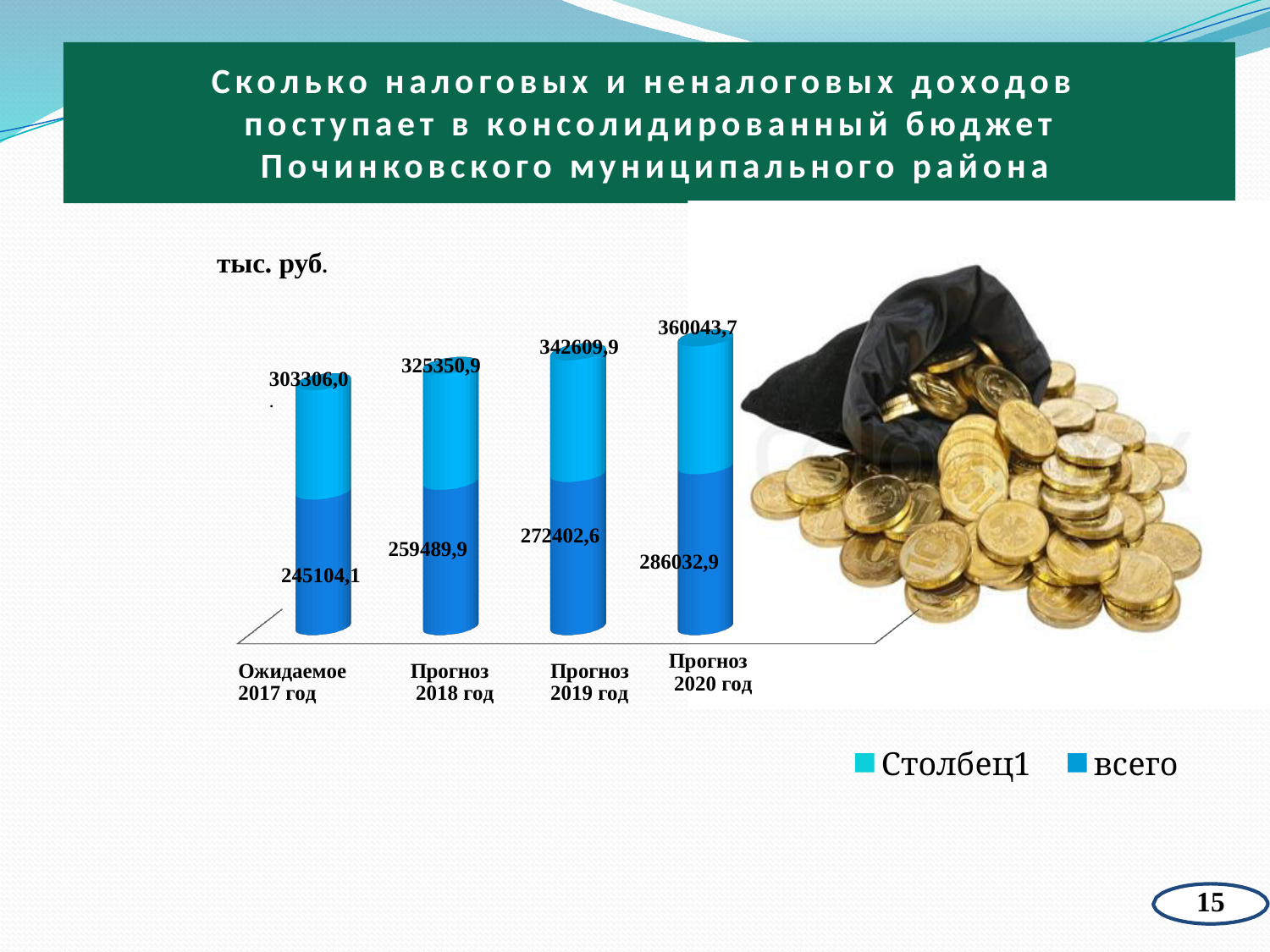
What is the value of the всего series for Прогноз 2019 год? 272402,6 What kind of chart is shown on the slide? bar chart Do the values of the всего series rise or fall from Ожидаемое 2017 год to Прогноз 2020 год? rise How many categories are shown along the x axis of the chart? 4 What unit label is printed above the chart? тыс. руб. What value is printed at the top of the bar for Прогноз 2018 год? 325350,9 Which category has the lowest value for the всего series? Ожидаемое 2017 год How many series does the chart legend list? 2 What is the value of the всего series for Ожидаемое 2017 год? 245104,1 What value is printed at the top of the bar for Прогноз 2020 год? 360043,7 What is the difference between the всего values for Прогноз 2020 год and Ожидаемое 2017 год? 40928,8 Which category has the highest value for the всего series? Прогноз 2020 год